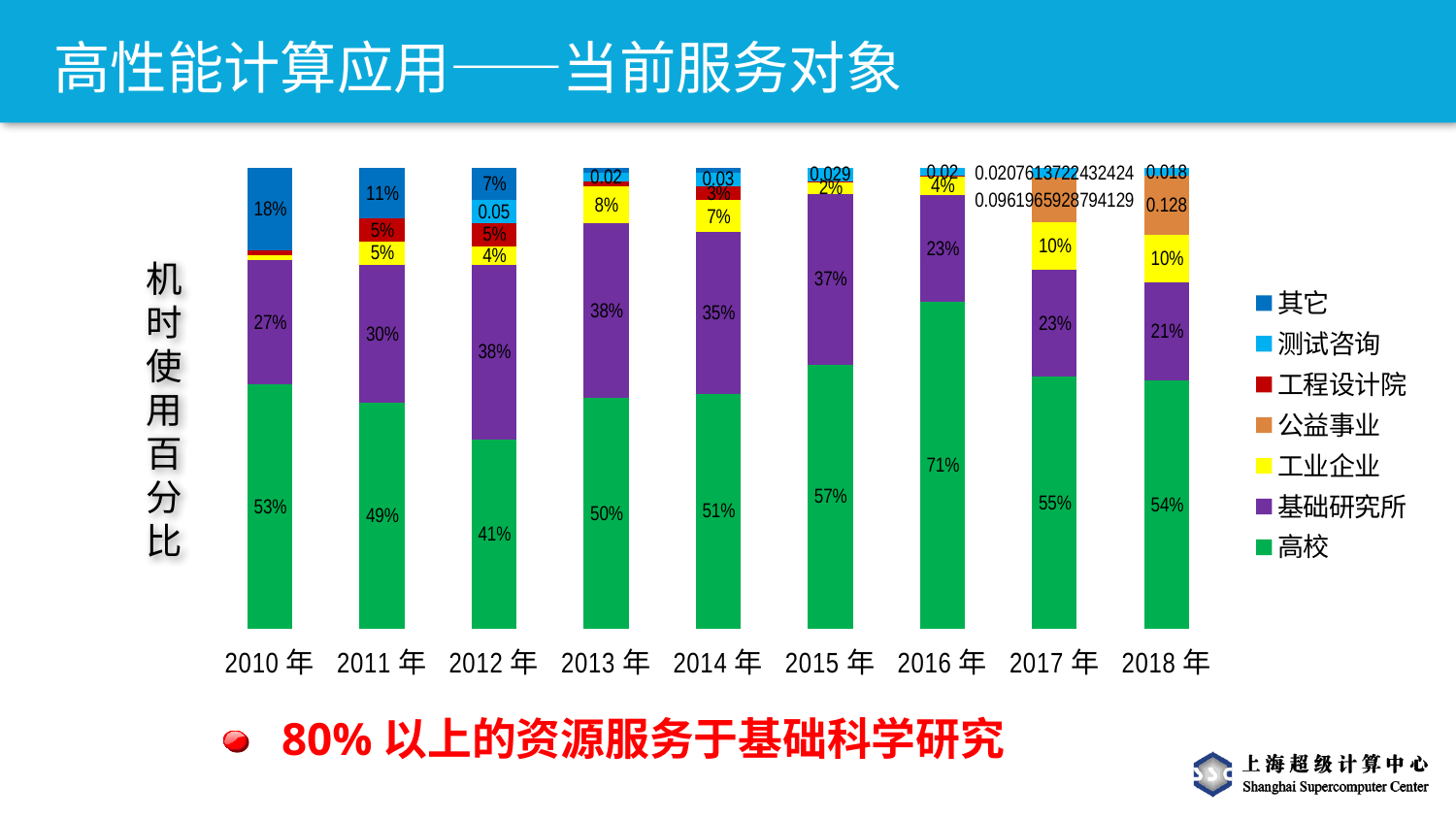
What is the value for 其它 in 2010 年? 18% Which is larger, the 基础研究所 value in 2011 年 or in 2018 年? 2011 年 What is the value for 高校 in 2016 年? 71% What is the value for 基础研究所 in 2012 年? 38% In which year is the 高校 share highest? 2016 年 What is the value for 公益事业 in 2018 年? 0.128 In which year is the 高校 share lowest? 2012 年 What is the value for 工业企业 in 2013 年? 8% What is the difference between the 高校 value in 2016 年 and in 2015 年? 14% How many series does the legend list? 7 What type of chart is shown on the slide? stacked bar chart How many years are shown on the x axis? 9